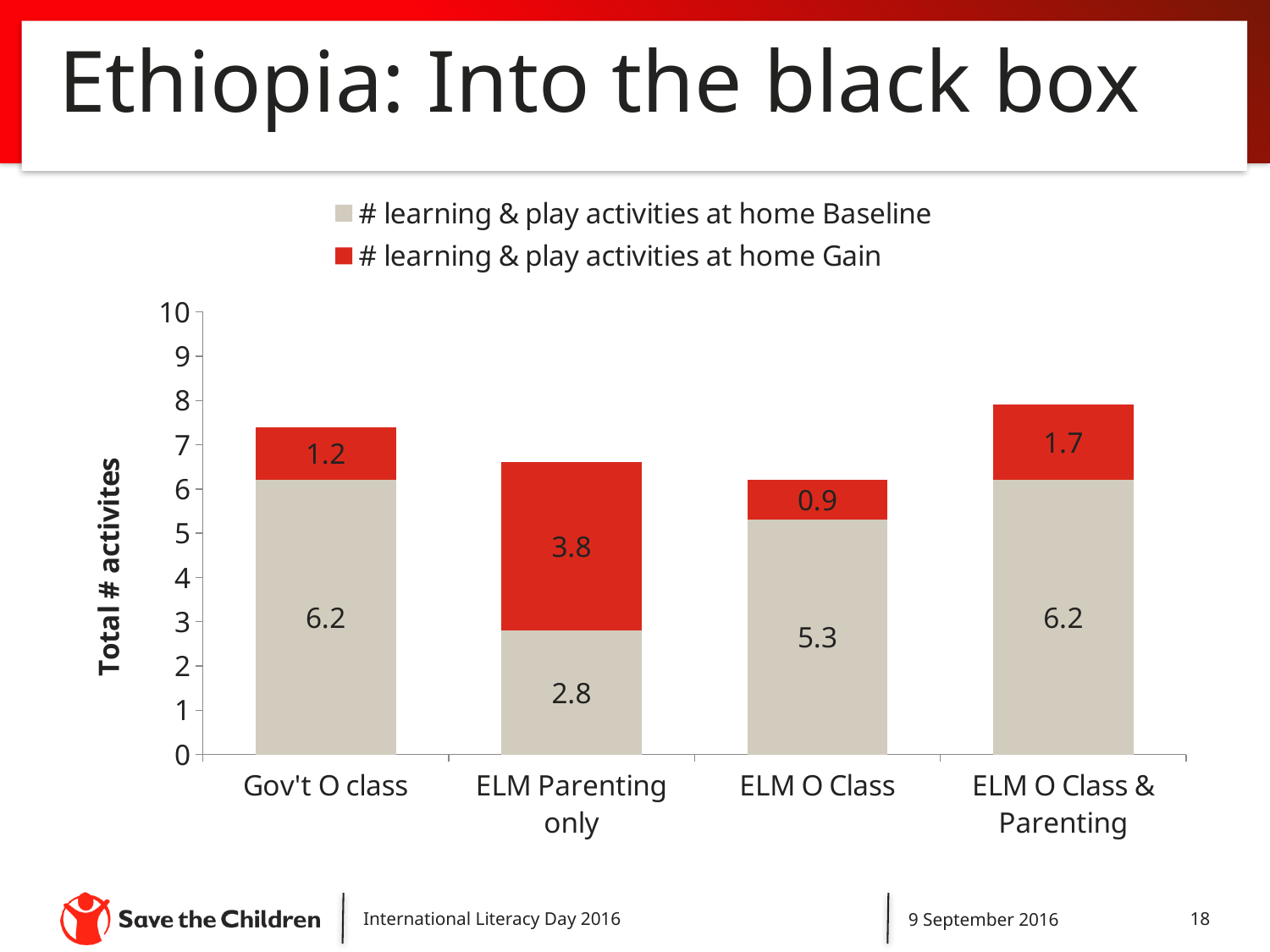
Which category has the lowest baseline number of learning & play activities at home? ELM Parenting only How many series does the legend list? 2 How many categories are shown on the x axis? 4 What type of chart is shown on the slide? Stacked bar chart What is the baseline number of learning & play activities at home for ELM Parenting only? 2.8 Which is larger: the gain for ELM O Class & Parenting or the gain for ELM O Class? ELM O Class & Parenting What is the total number of activities (baseline plus gain) for ELM O Class & Parenting? 7.9 What is the difference between the gain for ELM Parenting only and the gain for Gov't O class? 2.6 What is the gain in learning & play activities at home for ELM O Class & Parenting? 1.7 What is the total number of activities (baseline plus gain) for Gov't O class? 7.4 What is the gain value for ELM O Class? 0.9 Which category has the largest gain in learning & play activities at home? ELM Parenting only